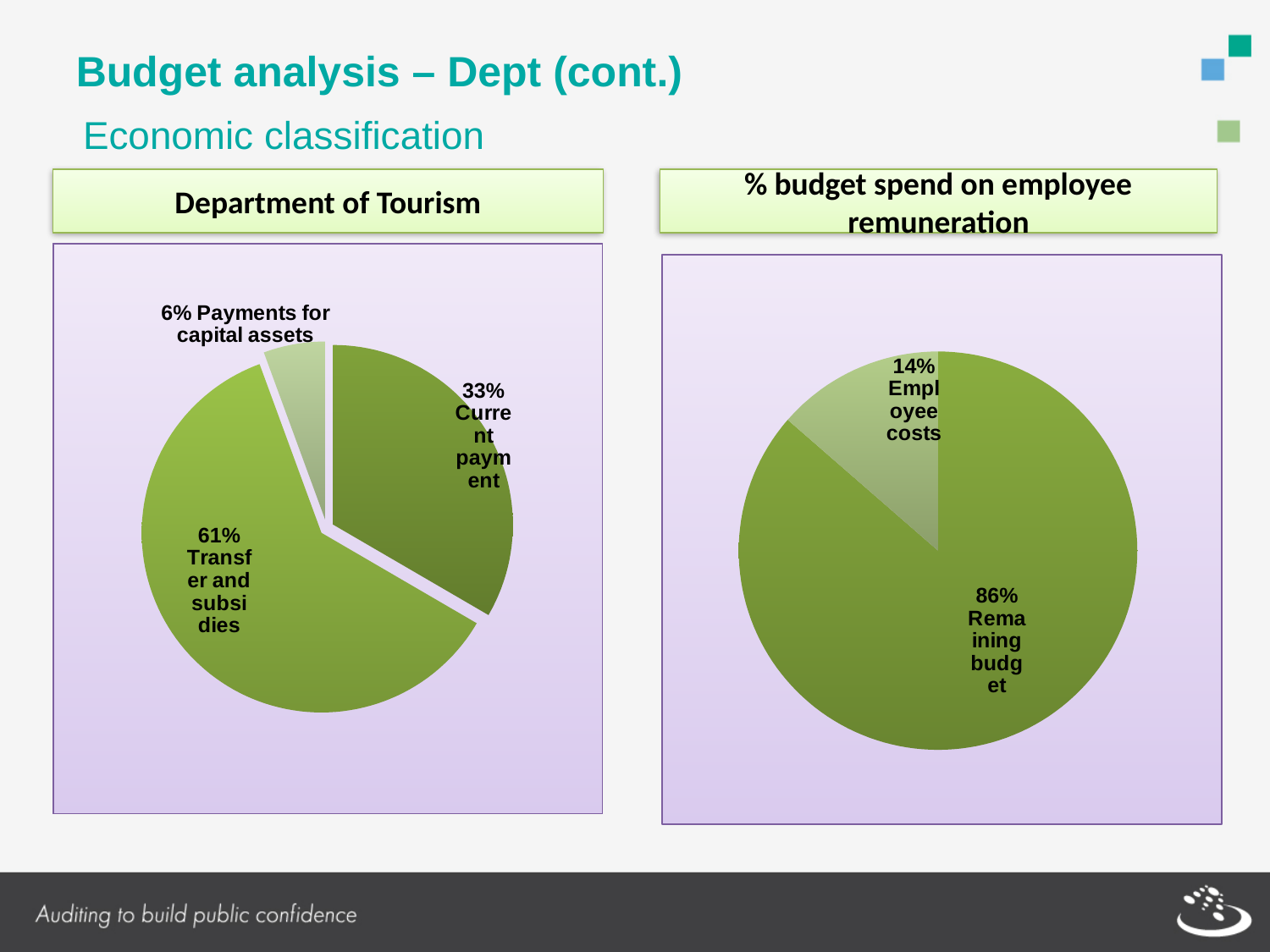
In the Department of Tourism chart, which category has the largest slice? Transfer and subsidies In the Department of Tourism chart, what is the difference between the Transfer and subsidies share and the Current payment share? 28% What kind of chart is the % budget spend on employee remuneration chart? Pie chart In the Department of Tourism chart, what share of the pie is Transfer and subsidies? 61% In the % budget spend on employee remuneration chart, what share of the pie is Employee costs? 14% In the % budget spend on employee remuneration chart, which is larger, Employee costs or Remaining budget? Remaining budget What is the title of the chart on the left of the slide? Department of Tourism In the Department of Tourism chart, what share of the pie is Payments for capital assets? 6% In the Department of Tourism chart, how many slices does the pie have? 3 In the Department of Tourism chart, which category has the smallest slice? Payments for capital assets